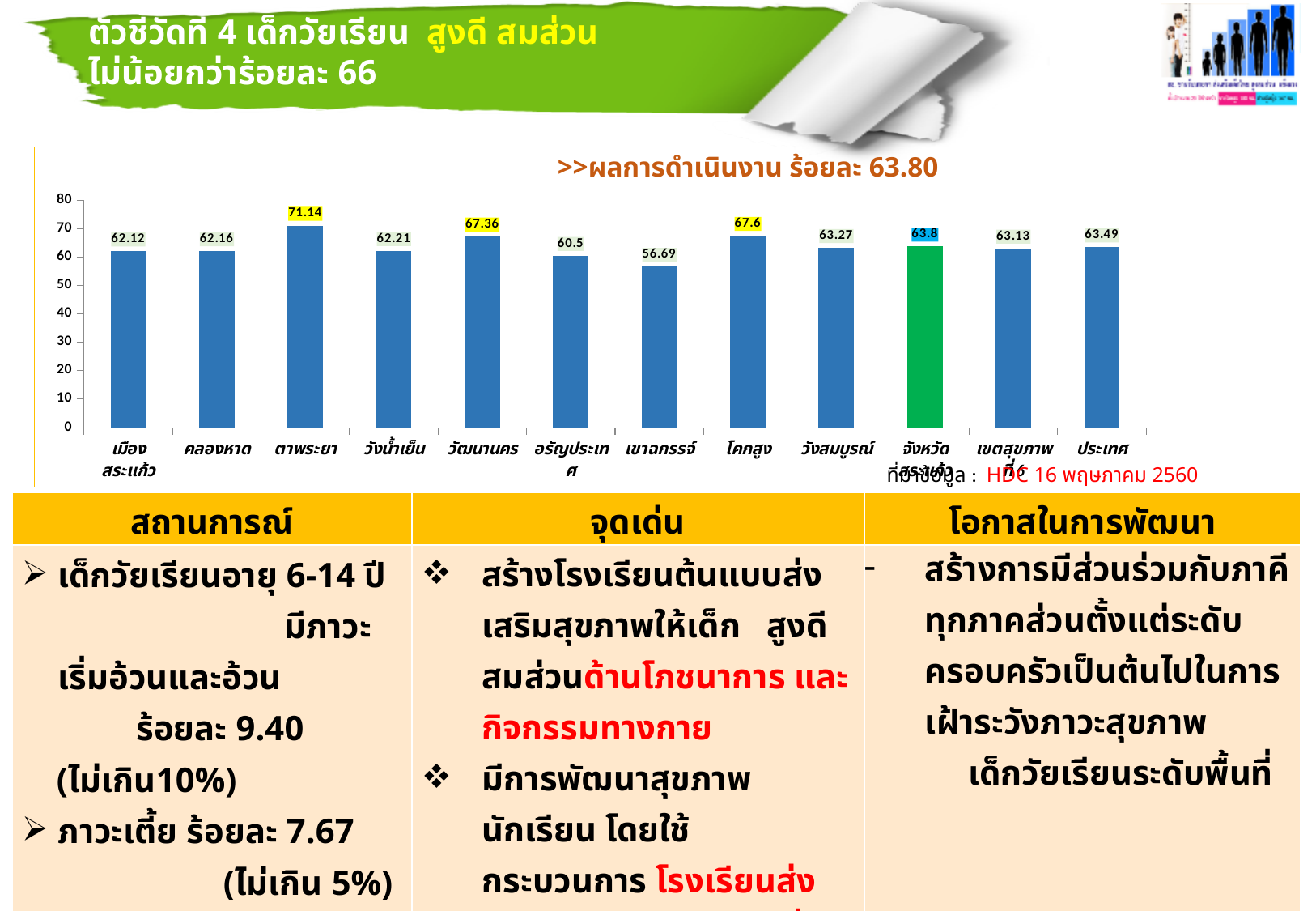
What is the value for ประเทศ? 63.49 What is the difference between the values for ตาพระยา and เขาฉกรรจ์? 14.45 What is the value for เขาฉกรรจ์? 56.69 Which category has the lowest value? เขาฉกรรจ์ What is the value for จังหวัดสระแก้ว? 63.8 Which bar is coloured green instead of blue? จังหวัดสระแก้ว Which category has the highest value? ตาพระยา What type of chart is shown on the slide? bar chart Is the value for อรัญประเทศ greater or less than 70? less How many categories are shown on the x axis? 12 What is the value for ตาพระยา? 71.14 Which is larger, the value for วัฒนานคร or the value for โคกสูง? โคกสูง